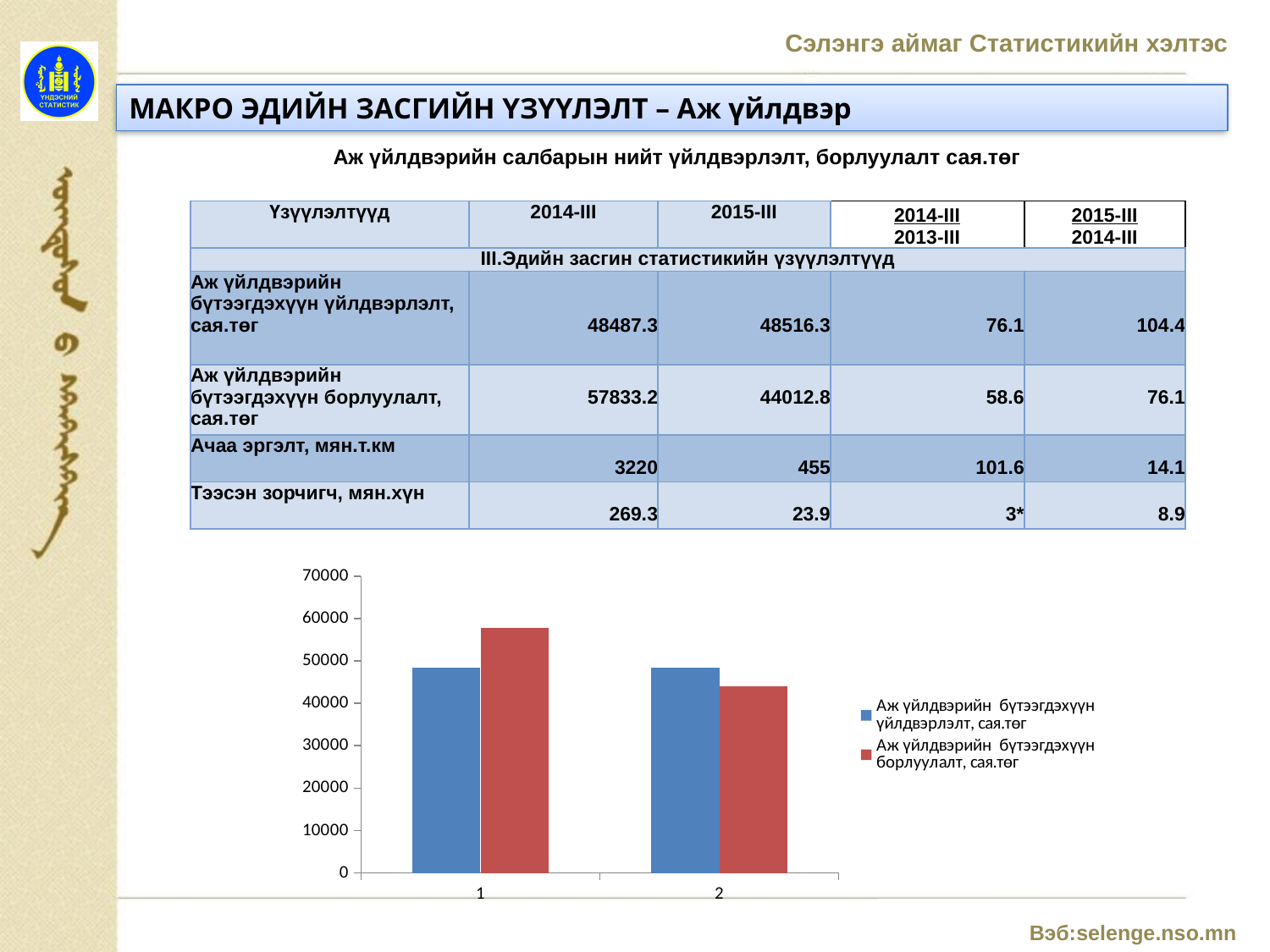
In the chart, which series is larger for category 2: Аж үйлдвэрийн бүтээгдэхүүн үйлдвэрлэлт or Аж үйлдвэрийн бүтээгдэхүүн борлуулалт? Аж үйлдвэрийн бүтээгдэхүүн үйлдвэрлэлт, сая.төг Is the value of Аж үйлдвэрийн бүтээгдэхүүн борлуулалт for category 2 greater or less than 40000? greater How many categories are shown on the x axis of the chart? 2 Is the value of Аж үйлдвэрийн бүтээгдэхүүн борлуулалт for category 1 greater or less than 50000? greater What is the highest value shown on the chart's y axis? 70000 In the chart, which series is larger for category 1: Аж үйлдвэрийн бүтээгдэхүүн үйлдвэрлэлт or Аж үйлдвэрийн бүтээгдэхүүн борлуулалт? Аж үйлдвэрийн бүтээгдэхүүн борлуулалт, сая.төг What kind of chart is shown on the slide? bar chart What colour are the bars for Аж үйлдвэрийн бүтээгдэхүүн борлуулалт, сая.төг in the chart? red Is the value of Аж үйлдвэрийн бүтээгдэхүүн үйлдвэрлэлт for category 1 greater or less than 50000? less How many series does the chart legend list? 2 Does the Аж үйлдвэрийн бүтээгдэхүүн борлуулалт series rise or fall from category 1 to category 2? fall